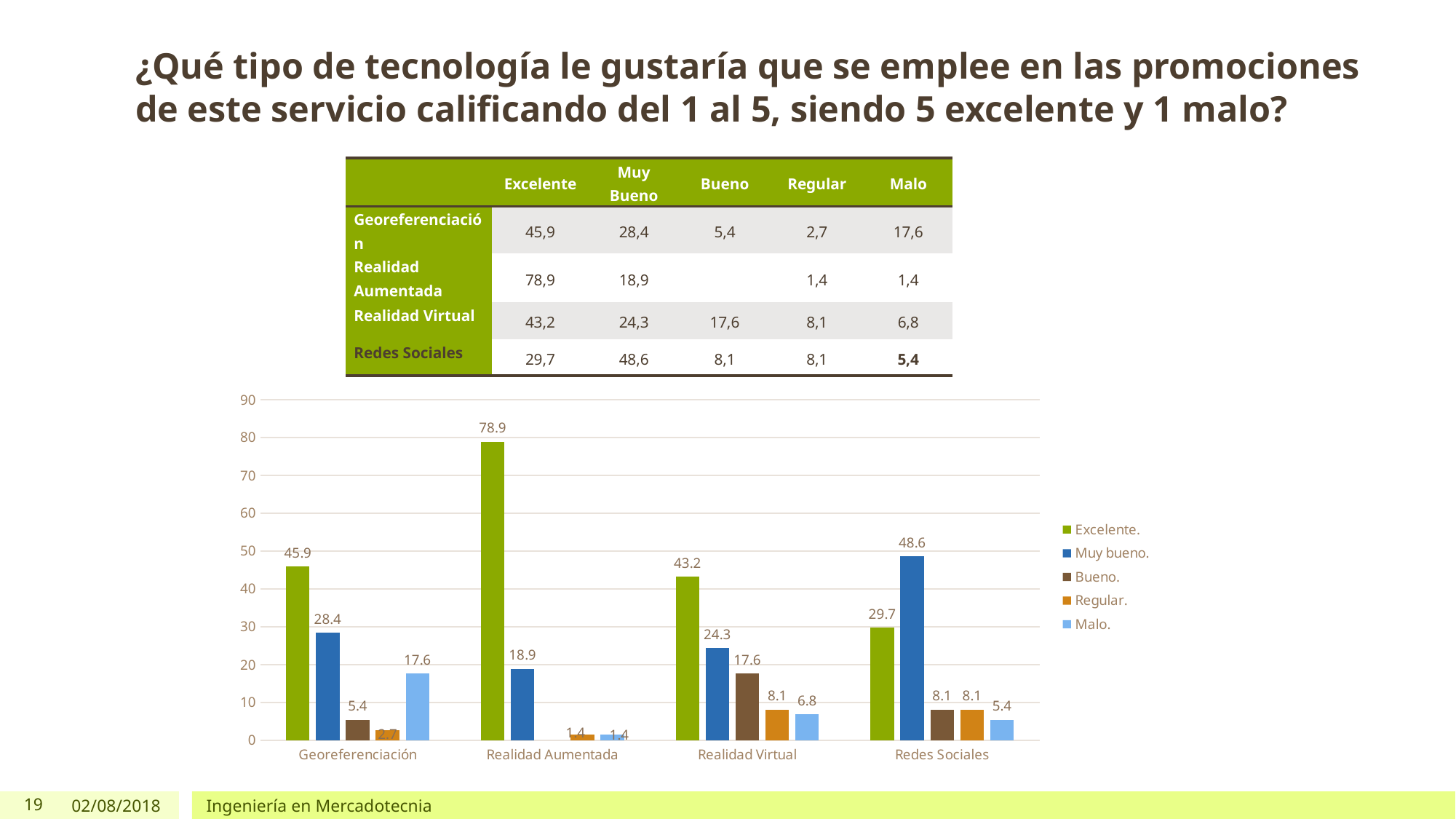
What type of chart is shown on the slide? bar chart Which category has the lowest Excelente value in the chart? Redes Sociales How many series does the chart legend list? 5 What is the Excelente value for Realidad Aumentada in the chart? 78.9 How many technology categories are shown on the x axis of the chart? 4 What is the Malo value for Georeferenciación in the chart? 17.6 What is the Muy bueno value for Redes Sociales in the chart? 48.6 Which is larger for Redes Sociales: the Excelente value or the Muy bueno value? Muy bueno Which legend entry is shown in light blue in the chart? Malo. Is the Excelente value for Realidad Virtual greater or less than 40? greater Which category has the highest Excelente value in the chart? Realidad Aumentada What is the difference between the Excelente values for Realidad Aumentada and Georeferenciación? 33.0